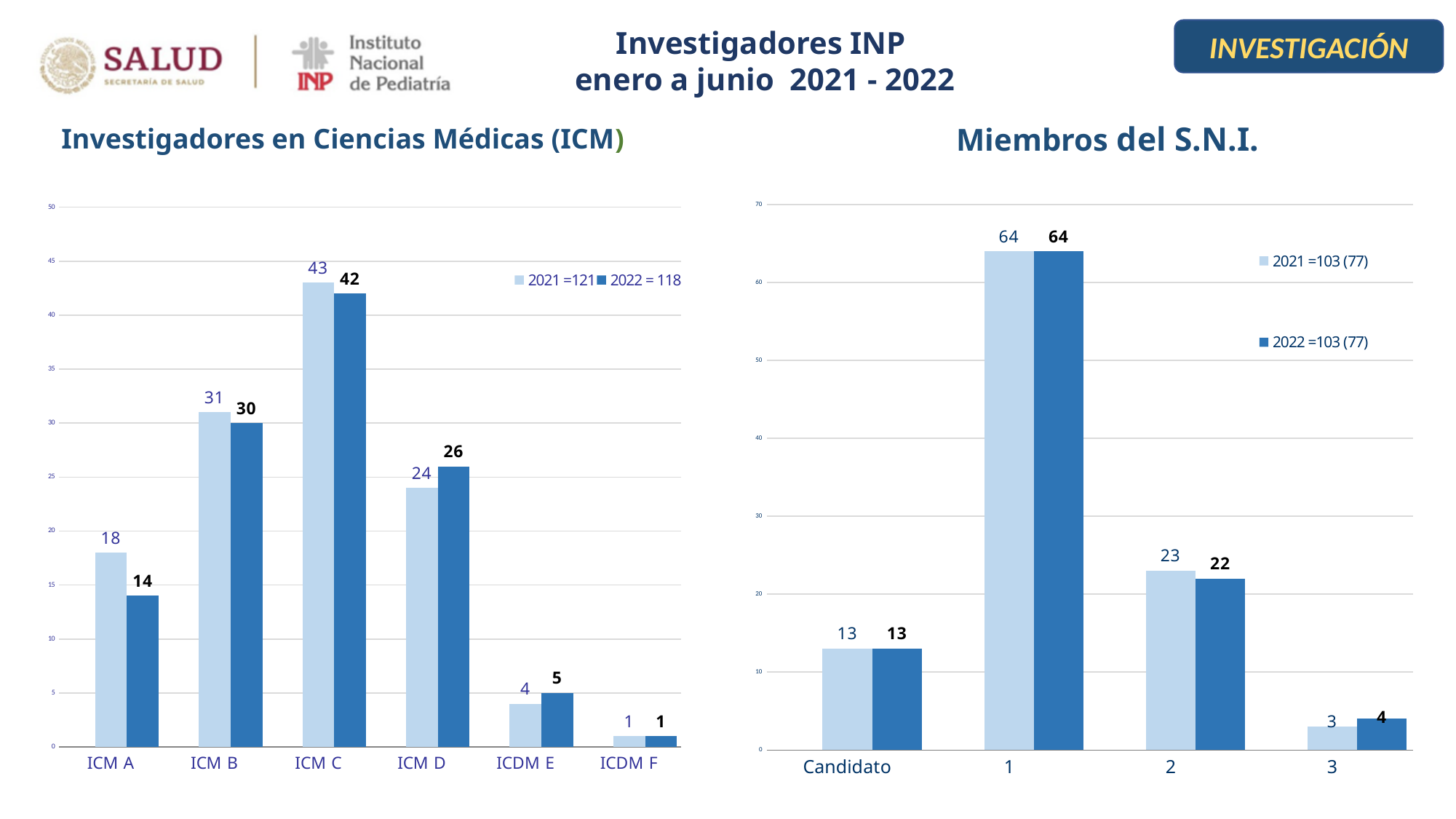
In the 'Investigadores en Ciencias Médicas (ICM)' chart, which category has the highest 2021 value? ICM C In the 'Investigadores en Ciencias Médicas (ICM)' chart, what is the 2022 value for ICM A? 14 What kind of chart is the 'Miembros del S.N.I.' chart? bar chart In the 'Investigadores en Ciencias Médicas (ICM)' chart, what is the difference between the 2021 and 2022 values for ICM A? 4 In the 'Investigadores en Ciencias Médicas (ICM)' chart, how many categories are shown on the x axis? 6 In the 'Investigadores en Ciencias Médicas (ICM)' chart, which category has the lowest 2022 value? ICDM F In the 'Miembros del S.N.I.' chart, what is the 2022 value for category 2? 22 In the 'Miembros del S.N.I.' chart, is the 2021 value for Candidato larger or smaller than the 2021 value for category 2? smaller In the 'Investigadores en Ciencias Médicas (ICM)' chart, what is the 2021 value for ICM C? 43 In the 'Miembros del S.N.I.' chart, which category has the highest 2021 value? 1 In the 'Miembros del S.N.I.' chart, what is the difference between the 2021 and 2022 values for category 3? 1 In the 'Investigadores en Ciencias Médicas (ICM)' chart, how many series does the legend list? 2